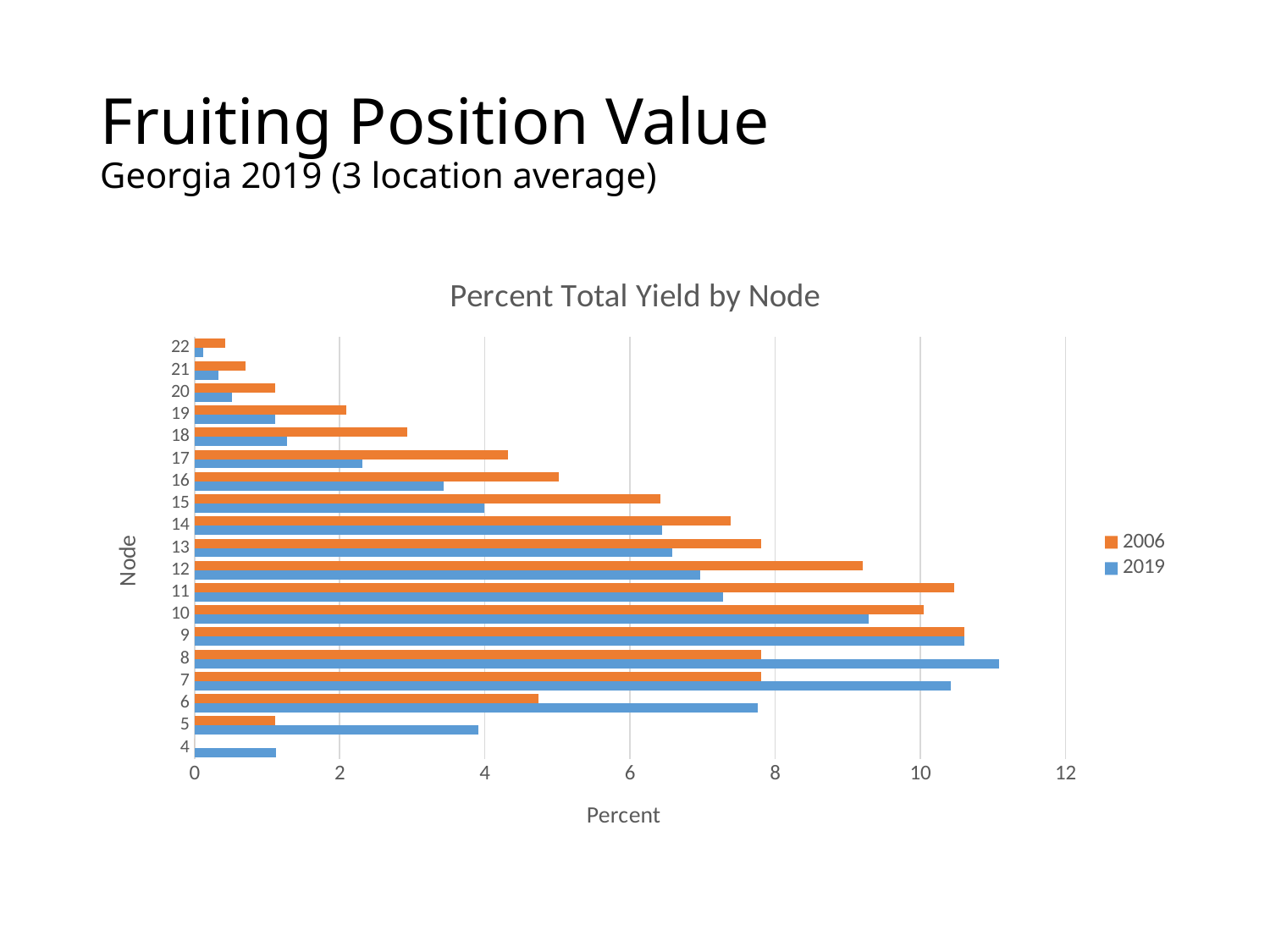
Is the 2019 value for node 8 greater or less than 10? greater Is the 2006 value for node 12 greater or less than 8? greater What is the title of the chart? Percent Total Yield by Node Which node has the lowest value for the 2019 series? 22 Which node has the highest value for the 2019 series? 8 Is the 2006 value for node 6 greater or less than 4? greater How many series does the legend list? 2 For node 15, which series has the larger value, 2006 or 2019? 2006 How many nodes (categories) are plotted on the chart? 19 For node 6, which series has the larger value, 2006 or 2019? 2019 What kind of chart is shown on the slide? bar chart What is the label of the horizontal axis? Percent